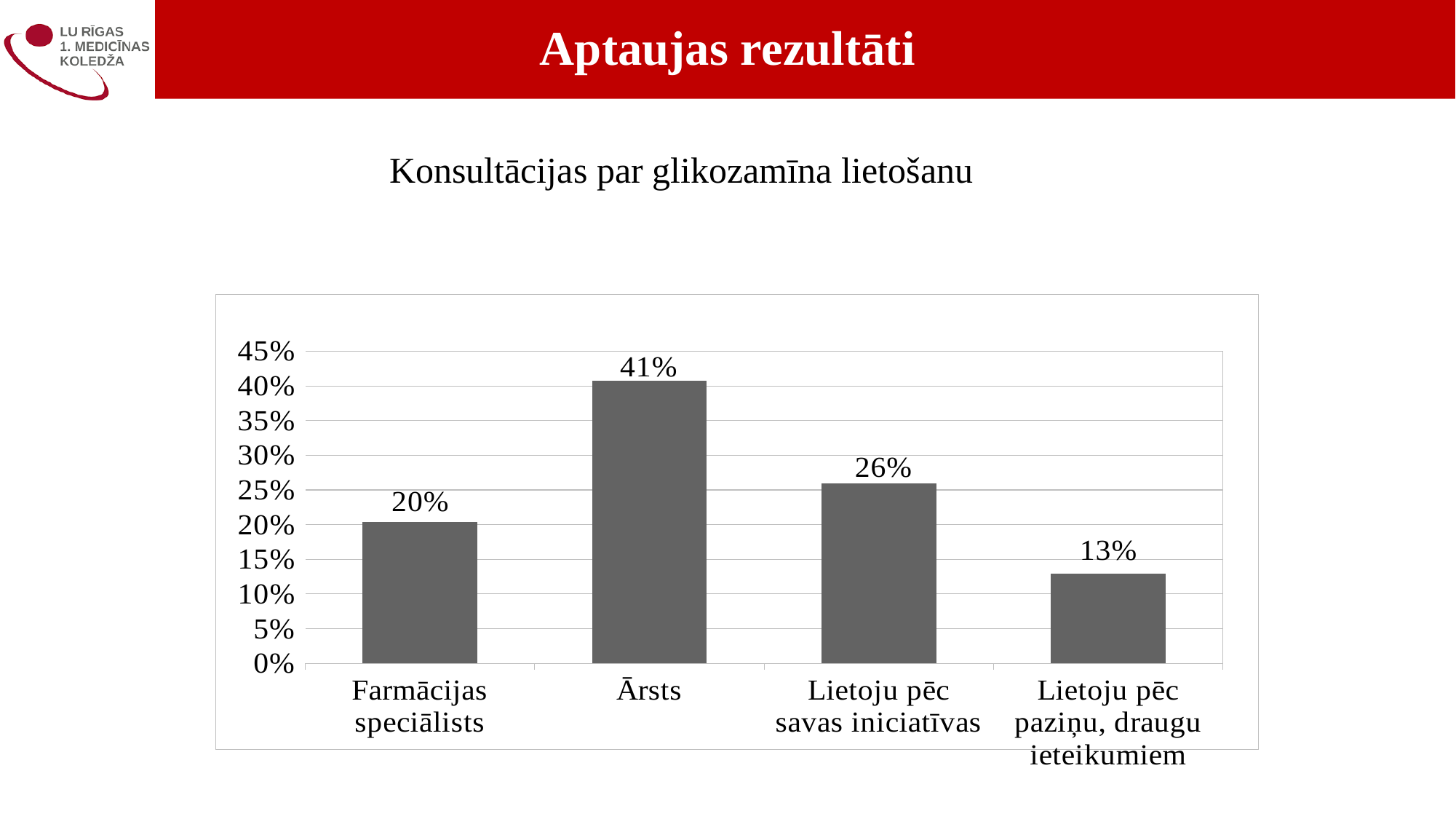
How many categories are shown in the chart? 4 Which is larger, the value for Farmācijas speciālists or the value for Lietoju pēc savas iniciatīvas? Lietoju pēc savas iniciatīvas What is the value for Lietoju pēc paziņu, draugu ieteikumiem? 13% What kind of chart is shown on the slide? Bar chart What is the value for Ārsts? 41% What is the title of the chart? Konsultācijas par glikozamīna lietošanu What is the difference between the values for Ārsts and Farmācijas speciālists? 21% What is the value for Lietoju pēc savas iniciatīvas? 26% Which category has the lowest value? Lietoju pēc paziņu, draugu ieteikumiem Which category has the highest value? Ārsts What is the value for Farmācijas speciālists? 20% What is the difference between the values for Lietoju pēc savas iniciatīvas and Lietoju pēc paziņu, draugu ieteikumiem? 13%